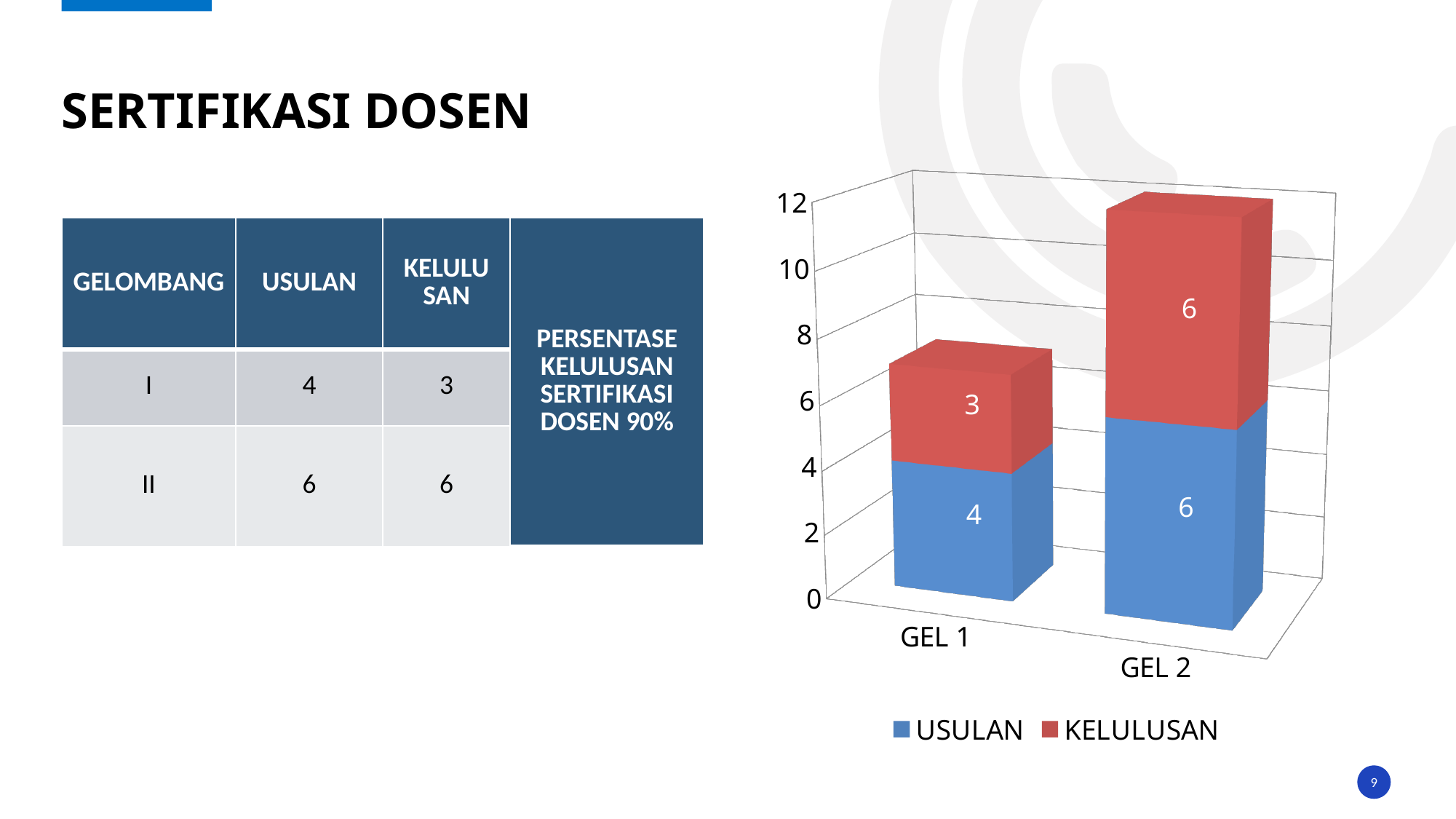
What is the KELULUSAN value for GEL 2? 6 What is the USULAN value for GEL 1? 4 Which category has the higher USULAN value, GEL 1 or GEL 2? GEL 2 What is the USULAN value for GEL 2? 6 What is the KELULUSAN value for GEL 1? 3 How many categories are shown on the x axis of the chart? 2 How many series does the chart legend list? 2 What is the total of the stacked bar for GEL 2? 12 What is the difference between the KELULUSAN values for GEL 2 and GEL 1? 3 What is the total of the stacked bar for GEL 1? 7 What kind of chart is shown on the slide? Stacked bar chart Which category has the lowest KELULUSAN value? GEL 1